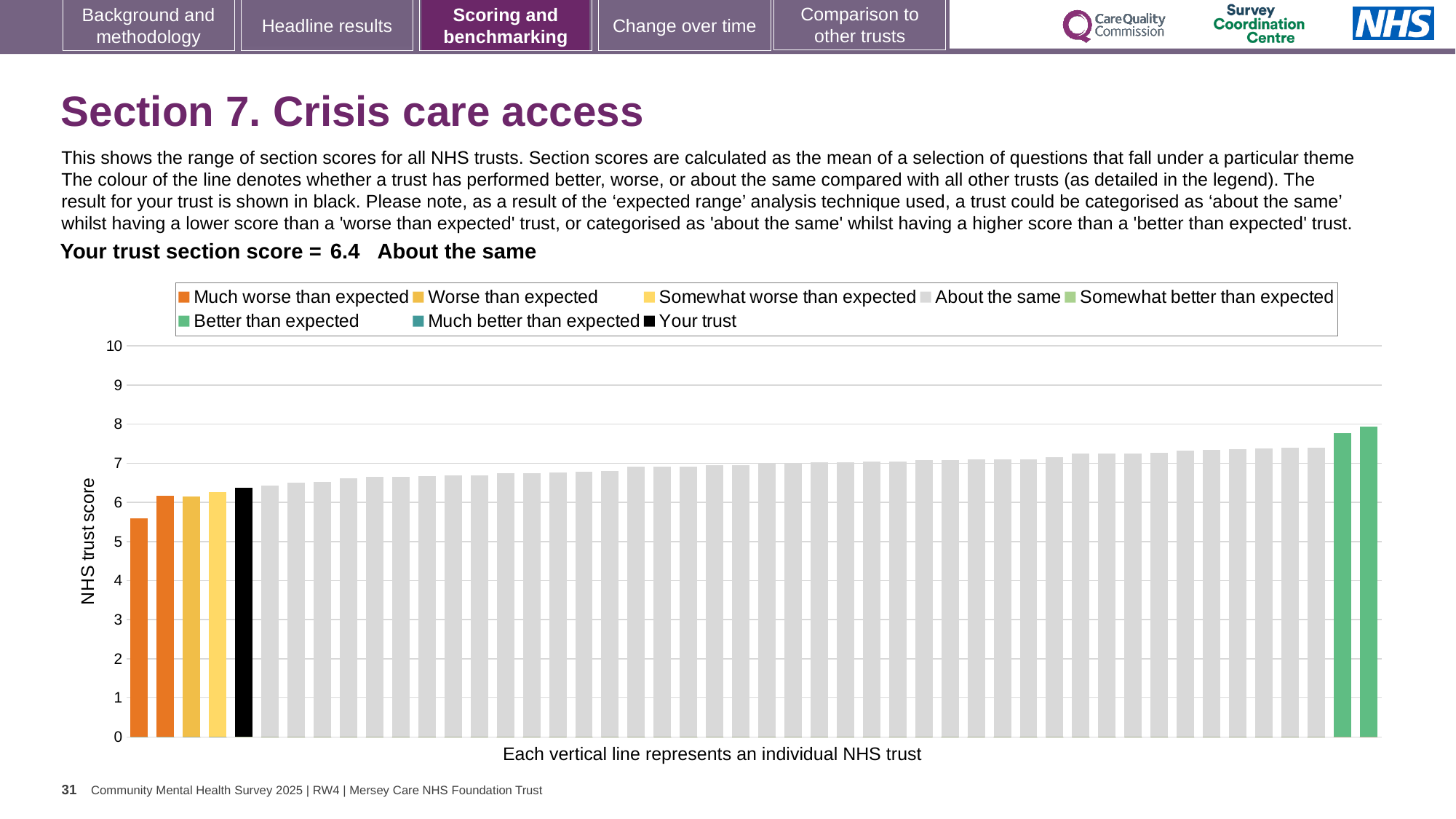
Which legend category does the lowest bar on the chart belong to? Much worse than expected Do the bar values rise or fall from left to right along the x axis? rise What colour is used for the 'Your trust' bar in the chart? black What kind of chart is shown on the slide? bar chart What is the label on the vertical axis of the chart? NHS trust score Is the value of the leftmost (lowest) bar greater or less than 6? less Is the value of the black 'Your trust' bar greater or less than 5? greater What is the section score for your trust shown on the slide? 6.4 Which category is your trust placed in for this section? About the same How many entries does the chart legend list? 8 Is the value of the rightmost (highest) bar greater or less than 7? greater How many bars are coloured green ('Better than expected')? 2